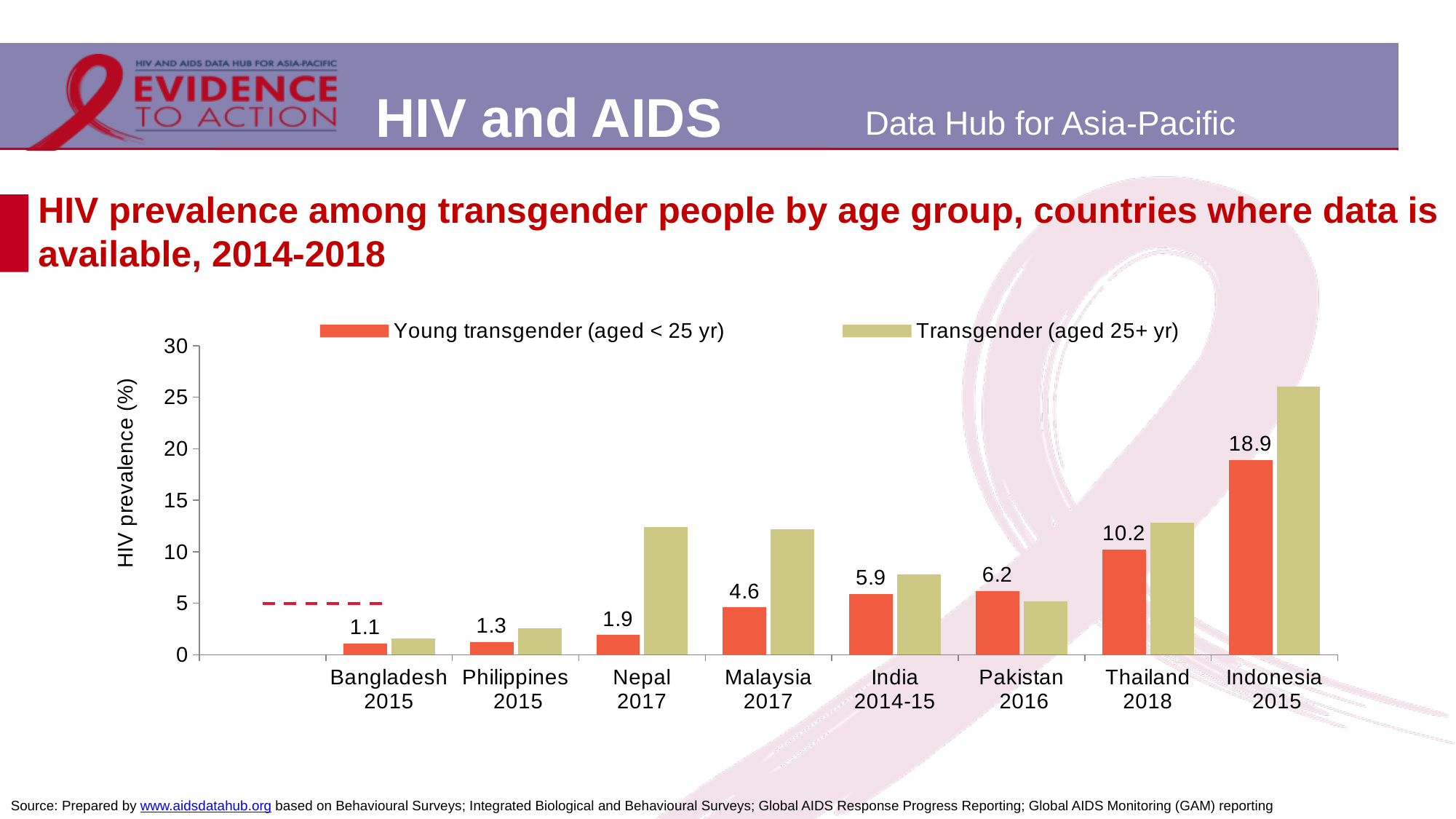
Which country has the lowest HIV prevalence among young transgender people (aged < 25 yr)? Bangladesh 2015 How many countries are shown on the x axis of the chart? 8 How many series does the chart legend list? 2 Is the HIV prevalence for transgender people aged 25+ yr in Nepal 2017 greater or less than 10? greater Which country has the highest HIV prevalence among young transgender people (aged < 25 yr)? Indonesia 2015 What is the difference in HIV prevalence among young transgender people (aged < 25 yr) between Indonesia 2015 and Thailand 2018? 8.7 What is the HIV prevalence among young transgender people (aged < 25 yr) in Thailand 2018? 10.2 What is the HIV prevalence among young transgender people (aged < 25 yr) in Indonesia 2015? 18.9 What is the HIV prevalence among young transgender people (aged < 25 yr) in Bangladesh 2015? 1.1 Is the HIV prevalence for transgender people aged 25+ yr in Indonesia 2015 greater or less than 25? greater What type of chart is shown on the slide? Bar chart Which is larger: the young transgender (aged < 25 yr) HIV prevalence in Pakistan 2016 or in India 2014-15? Pakistan 2016